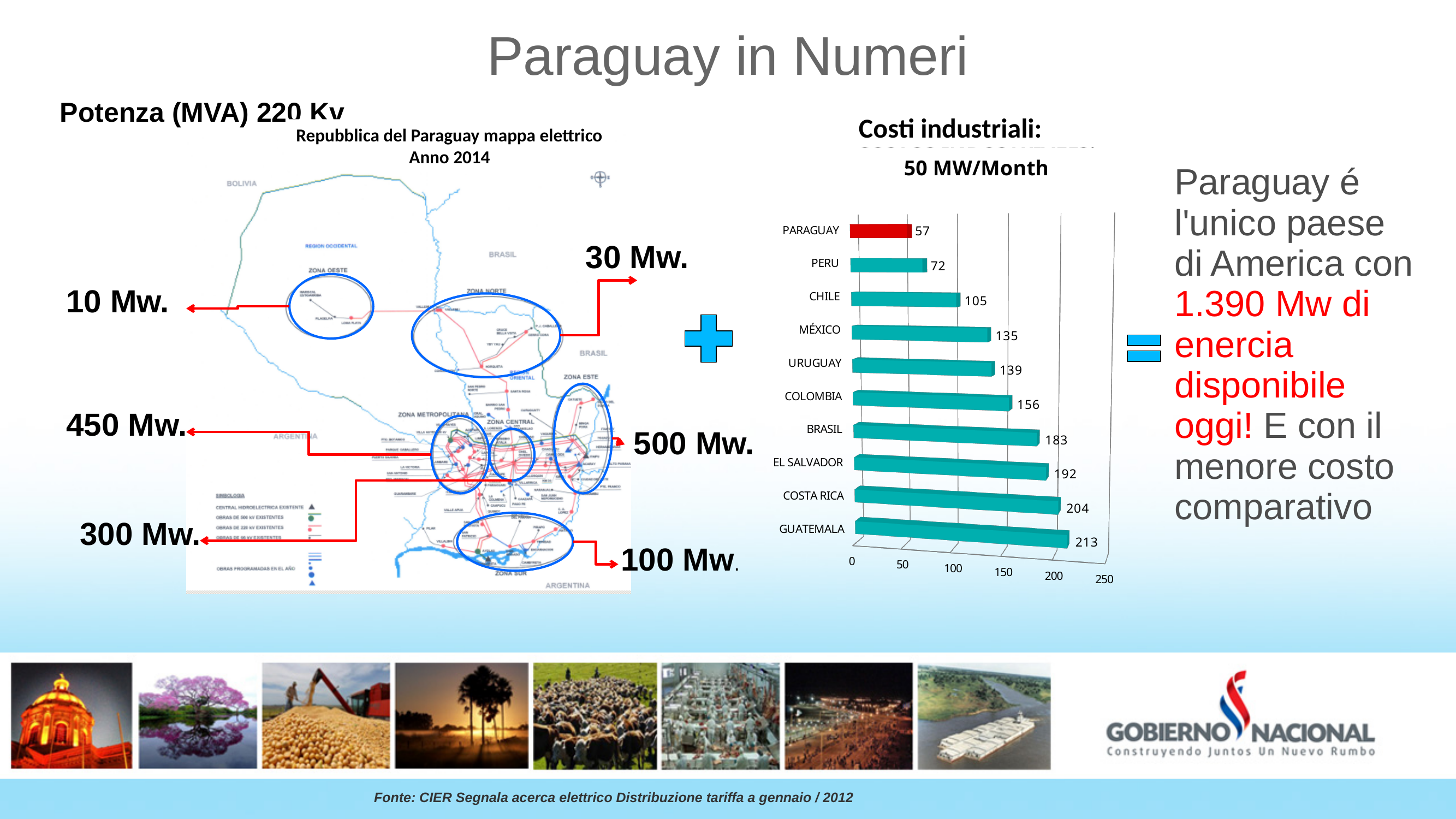
In the 'Costi industriali: 50 MW/Month' chart, what is the value for PARAGUAY? 57 In the 'Costi industriali: 50 MW/Month' chart, which country has the lowest value? PARAGUAY In the 'Costi industriali: 50 MW/Month' chart, what is the value for BRASIL? 183 In the 'Costi industriali: 50 MW/Month' chart, which country's bar is coloured red instead of teal? PARAGUAY In the 'Costi industriali: 50 MW/Month' chart, which country has the highest value? GUATEMALA In the 'Costi industriali: 50 MW/Month' chart, what is the difference between the values for GUATEMALA and PARAGUAY? 156 What kind of chart is the 'Costi industriali: 50 MW/Month' chart? bar chart In the 'Costi industriali: 50 MW/Month' chart, is the value for MÉXICO greater or less than 100? greater In the 'Costi industriali: 50 MW/Month' chart, what is the difference between the values for COSTA RICA and EL SALVADOR? 12 In the 'Costi industriali: 50 MW/Month' chart, which has a larger value, CHILE or COLOMBIA? COLOMBIA How many countries are shown in the 'Costi industriali: 50 MW/Month' chart? 10 In the 'Costi industriali: 50 MW/Month' chart, what is the value for URUGUAY? 139